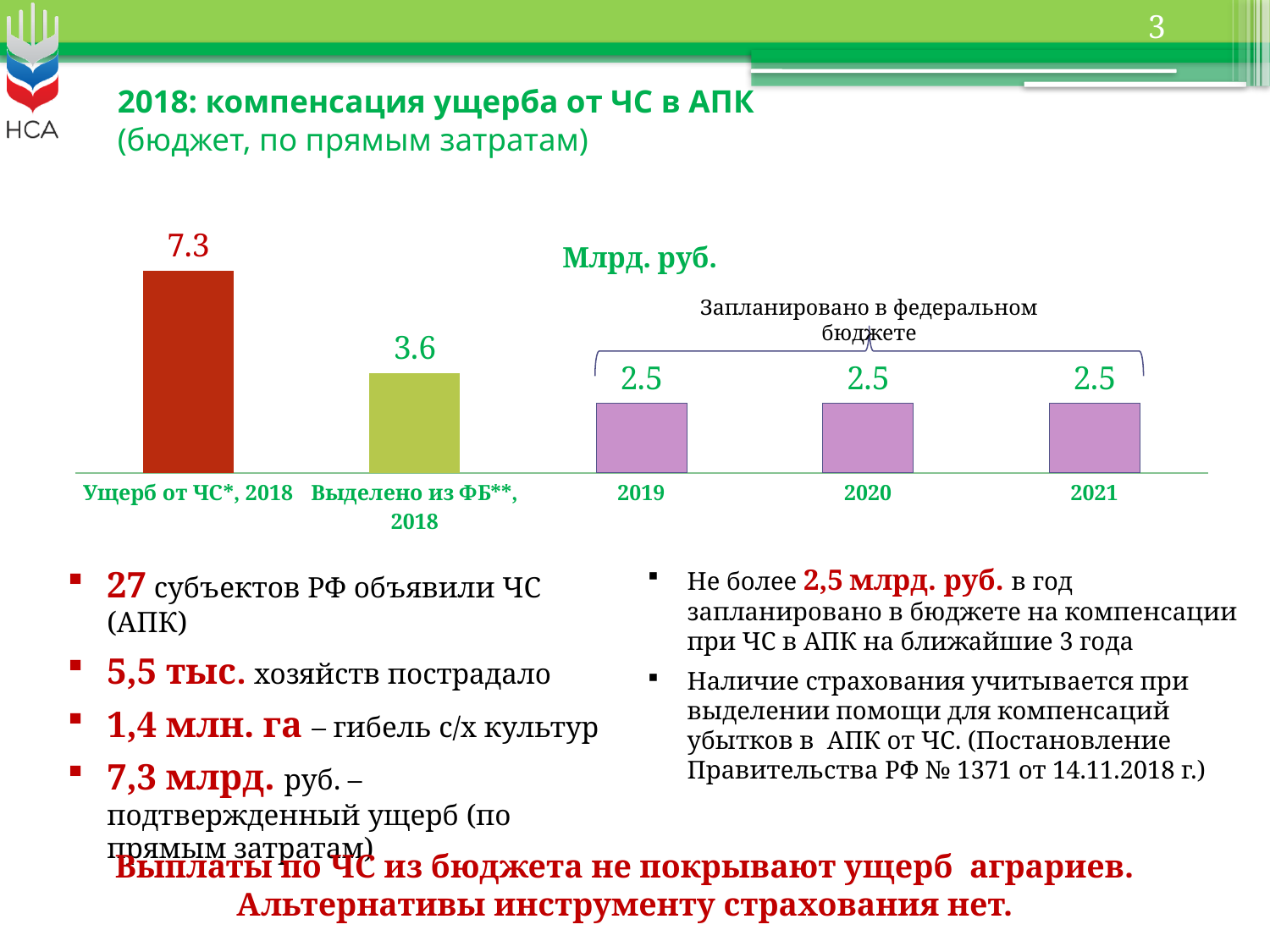
What is the difference between the value for "Выделено из ФБ**, 2018" and the value for 2019? 1.1 What is the difference between the value for "Ущерб от ЧС*, 2018" and the value for "Выделено из ФБ**, 2018"? 3.7 What value is shown for the bar labelled "Выделено из ФБ**, 2018"? 3.6 How many bars are plotted in the chart? 5 What value is shown for 2020? 2.5 Which is larger: the value for "Выделено из ФБ**, 2018" or the value for 2021? Выделено из ФБ**, 2018 What unit is stated for the values in the chart? Млрд. руб. Which category has the highest bar? Ущерб от ЧС*, 2018 Do the values rise or fall from "Ущерб от ЧС*, 2018" to 2019? Fall What kind of chart is shown on the slide? Bar chart Which years are grouped under the label "Запланировано в федеральном бюджете"? 2019, 2020, 2021 What value is shown for the bar labelled "Ущерб от ЧС*, 2018"? 7.3